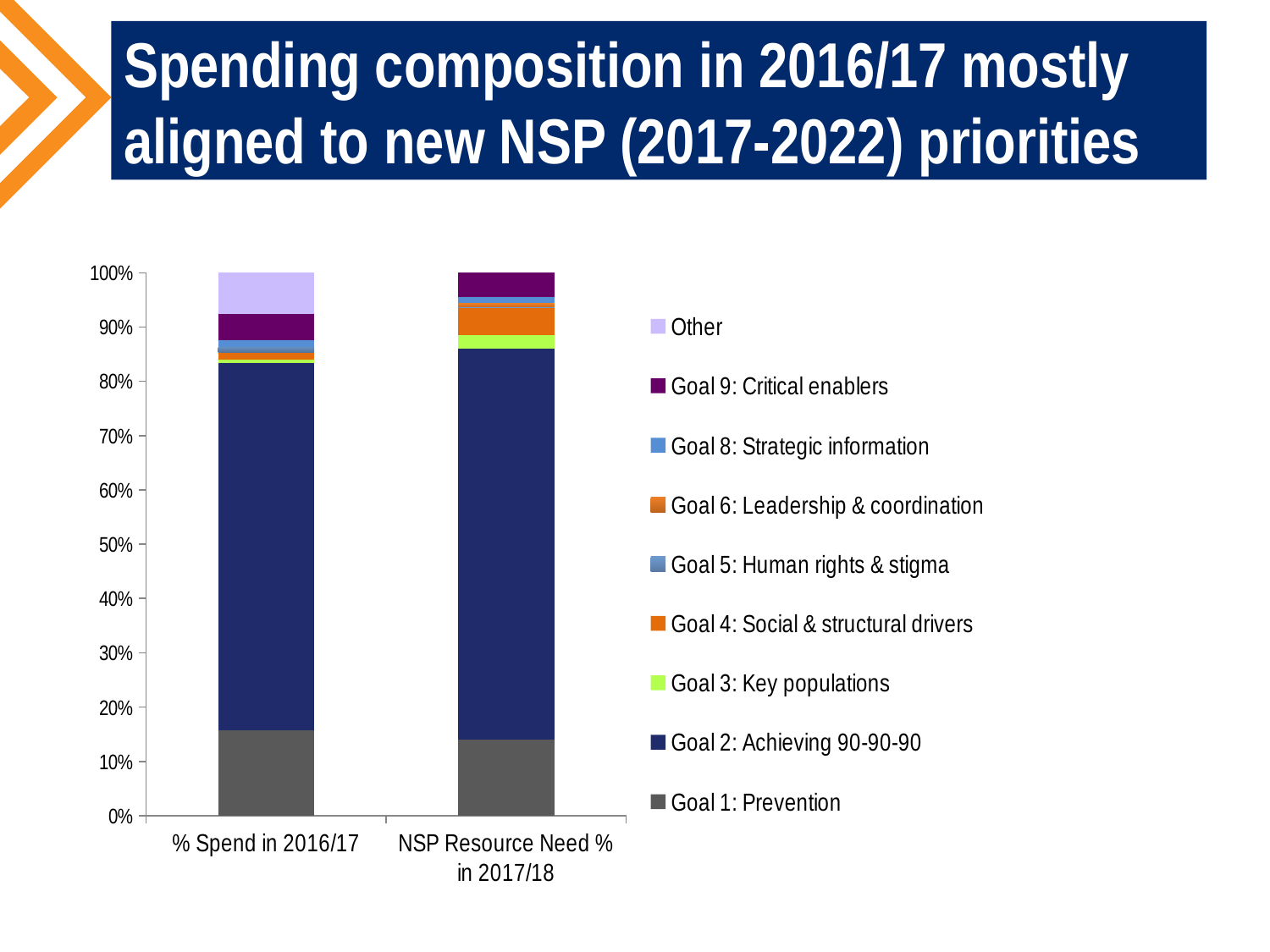
What is the total height of the % Spend in 2016/17 stacked bar? 100% How many bars (categories) are plotted on the x axis? 2 Is the Goal 1: Prevention segment for % Spend in 2016/17 greater or less than 10%? greater What kind of chart is shown on the slide? Stacked bar chart What are the two category labels on the x axis? % Spend in 2016/17 and NSP Resource Need % in 2017/18 How many series does the legend list? 9 Is the top of the Goal 2: Achieving 90-90-90 segment for % Spend in 2016/17 greater or less than 80%? greater Is the Goal 1: Prevention segment for % Spend in 2016/17 greater or less than 20%? less Which series makes up the largest segment in both bars? Goal 2: Achieving 90-90-90 Which legend entry is shown at the bottom of the legend? Goal 1: Prevention Which bar includes an 'Other' segment: % Spend in 2016/17 or NSP Resource Need % in 2017/18? % Spend in 2016/17